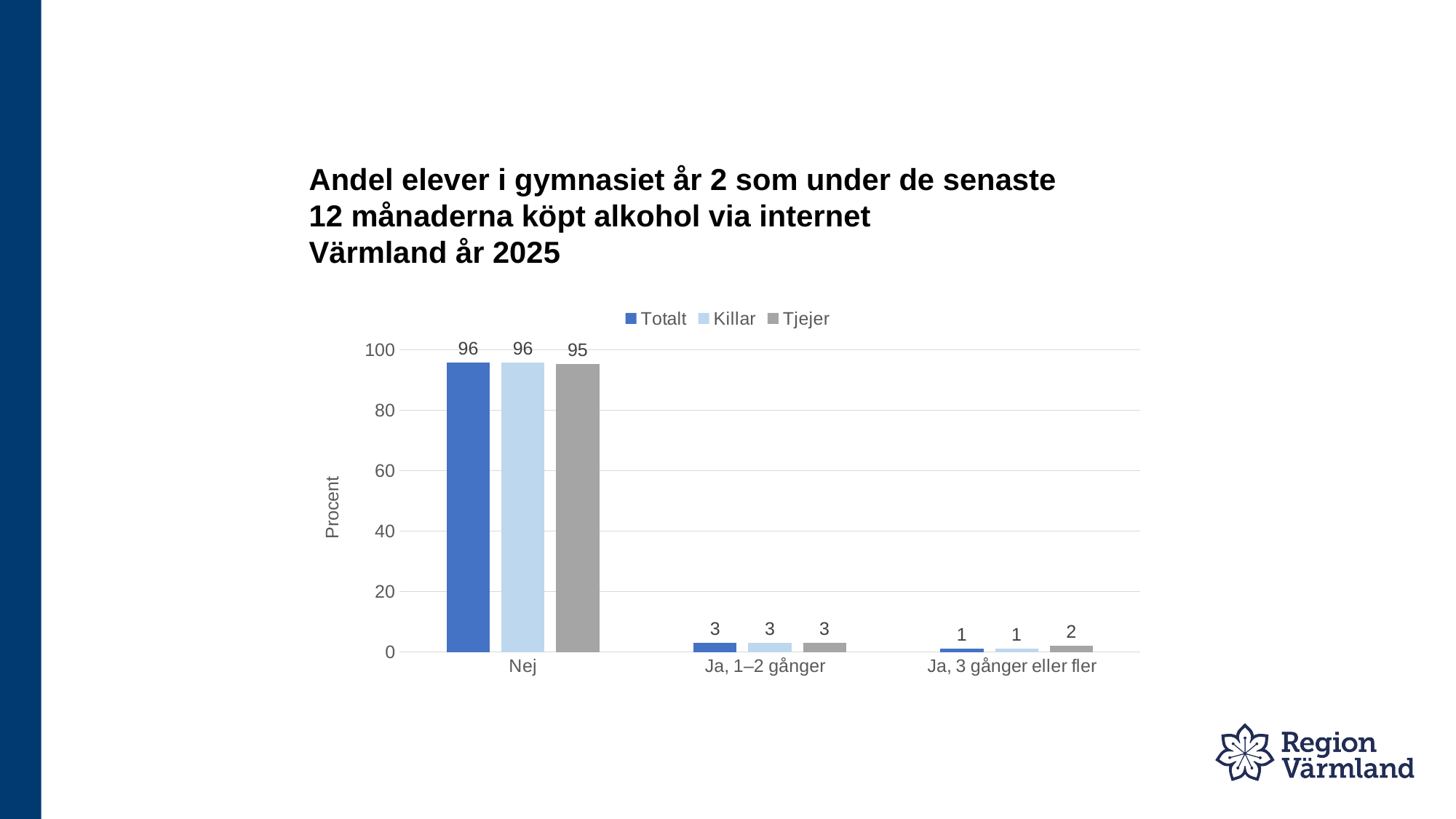
What is the difference between the Totalt value for Nej and the Totalt value for 'Ja, 1–2 gånger'? 93 What is the label of the y axis? Procent Which category has the lowest value for Killar? Ja, 3 gånger eller fler What is the value for Totalt in the Nej category? 96 What is the value for Killar in the 'Ja, 1–2 gånger' category? 3 How many categories are shown on the x axis? 3 Which category has the highest value for Totalt? Nej What is the value for Tjejer in the 'Ja, 3 gånger eller fler' category? 2 In the 'Ja, 3 gånger eller fler' category, which is larger, the value for Killar or the value for Tjejer? Tjejer What kind of chart is shown on the slide? Bar chart What is the value for Tjejer in the Nej category? 95 How many series does the legend list? 3